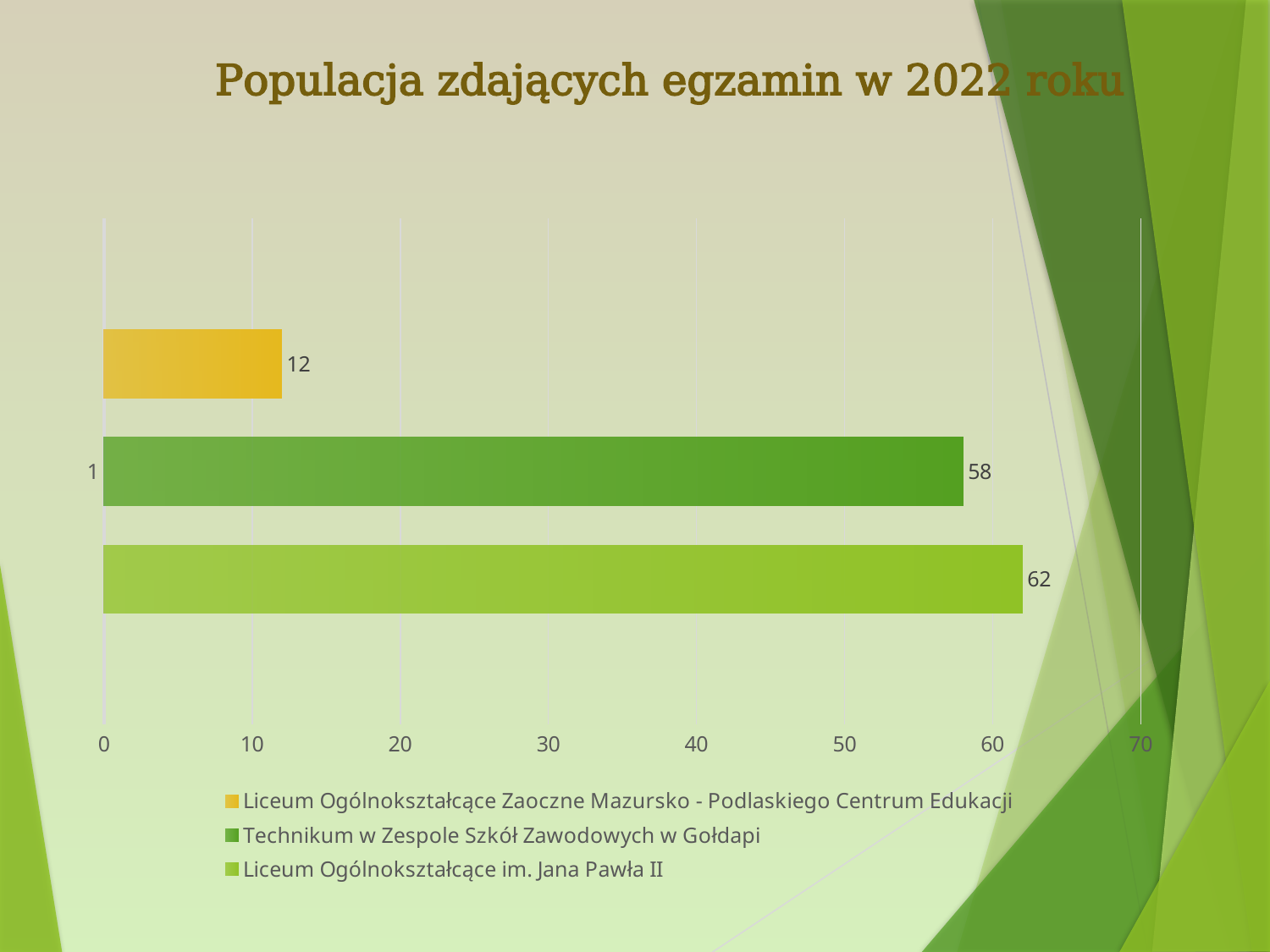
What is the value for Technikum w Zespole Szkół Zawodowych w Gołdapi? 58 Which school has the highest value? Liceum Ogólnokształcące im. Jana Pawła II What kind of chart is shown on the slide? bar chart What is the title of the chart? Populacja zdających egzamin w 2022 roku What is the value for Liceum Ogólnokształcące Zaoczne Mazursko - Podlaskiego Centrum Edukacji? 12 Is the value for Technikum w Zespole Szkół Zawodowych w Gołdapi greater or less than 50? greater What is the difference between the values for Liceum Ogólnokształcące im. Jana Pawła II and Technikum w Zespole Szkół Zawodowych w Gołdapi? 4 How many series does the legend list? 3 Which is larger: the value for Technikum w Zespole Szkół Zawodowych w Gołdapi or the value for Liceum Ogólnokształcące Zaoczne Mazursko - Podlaskiego Centrum Edukacji? Technikum w Zespole Szkół Zawodowych w Gołdapi What is the difference between the values for Technikum w Zespole Szkół Zawodowych w Gołdapi and Liceum Ogólnokształcące Zaoczne Mazursko - Podlaskiego Centrum Edukacji? 46 What is the value for Liceum Ogólnokształcące im. Jana Pawła II? 62 Which school has the lowest value? Liceum Ogólnokształcące Zaoczne Mazursko - Podlaskiego Centrum Edukacji